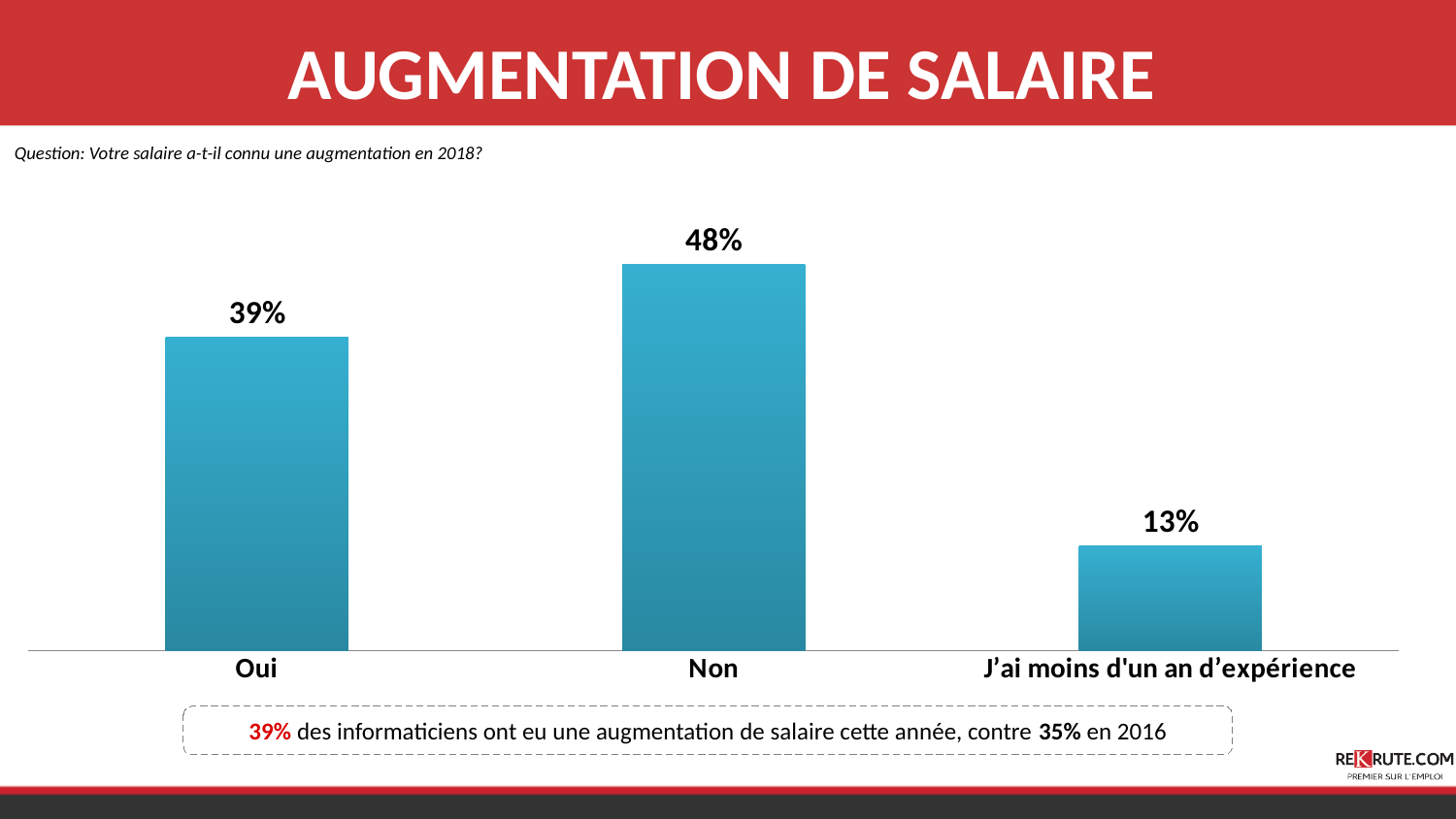
What is the title of the slide? AUGMENTATION DE SALAIRE What is the value for "Non"? 48% What is the value for "Oui"? 39% What colour are the bars in the chart? Blue How many categories are shown in the chart? 3 What kind of chart is shown on the slide? Bar chart What is the difference between the values for "Non" and "Oui"? 9% Which category has the highest value? Non What is the difference between the values for "Oui" and "J'ai moins d'un an d'expérience"? 26% Which is larger, the value for "Oui" or the value for "Non"? Non What is the value for "J'ai moins d'un an d'expérience"? 13% Which category has the lowest value? J'ai moins d'un an d'expérience